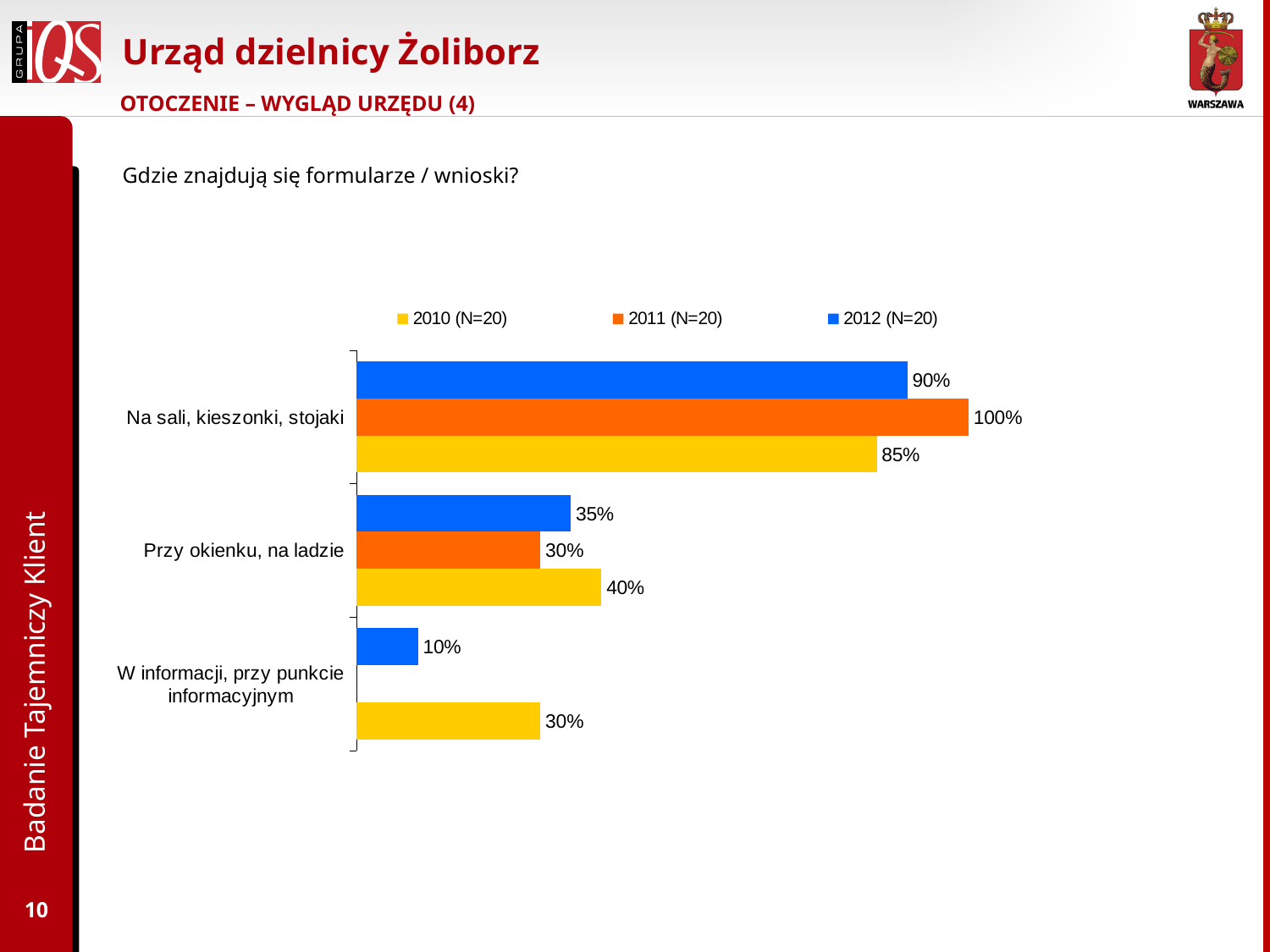
What kind of chart is shown on the slide? Bar chart Which category has the highest value in the 2012 (N=20) series? Na sali, kieszonki, stojaki What is the value for 'Przy okienku, na ladzie' in the 2012 (N=20) series? 35% How many series does the legend list? 3 What is the difference between the 2011 (N=20) and 2010 (N=20) values for 'Na sali, kieszonki, stojaki'? 15% What is the value for 'Na sali, kieszonki, stojaki' in the 2010 (N=20) series? 85% How many categories are shown on the chart? 3 Which category has the lowest value in the 2012 (N=20) series? W informacji, przy punkcie informacyjnym What is the value for 'W informacji, przy punkcie informacyjnym' in the 2010 (N=20) series? 30% Which is larger for 'Przy okienku, na ladzie': the 2010 (N=20) value or the 2011 (N=20) value? 2010 (N=20) What is the value for 'Na sali, kieszonki, stojaki' in the 2011 (N=20) series? 100% What colour represents the 2011 (N=20) series? Orange